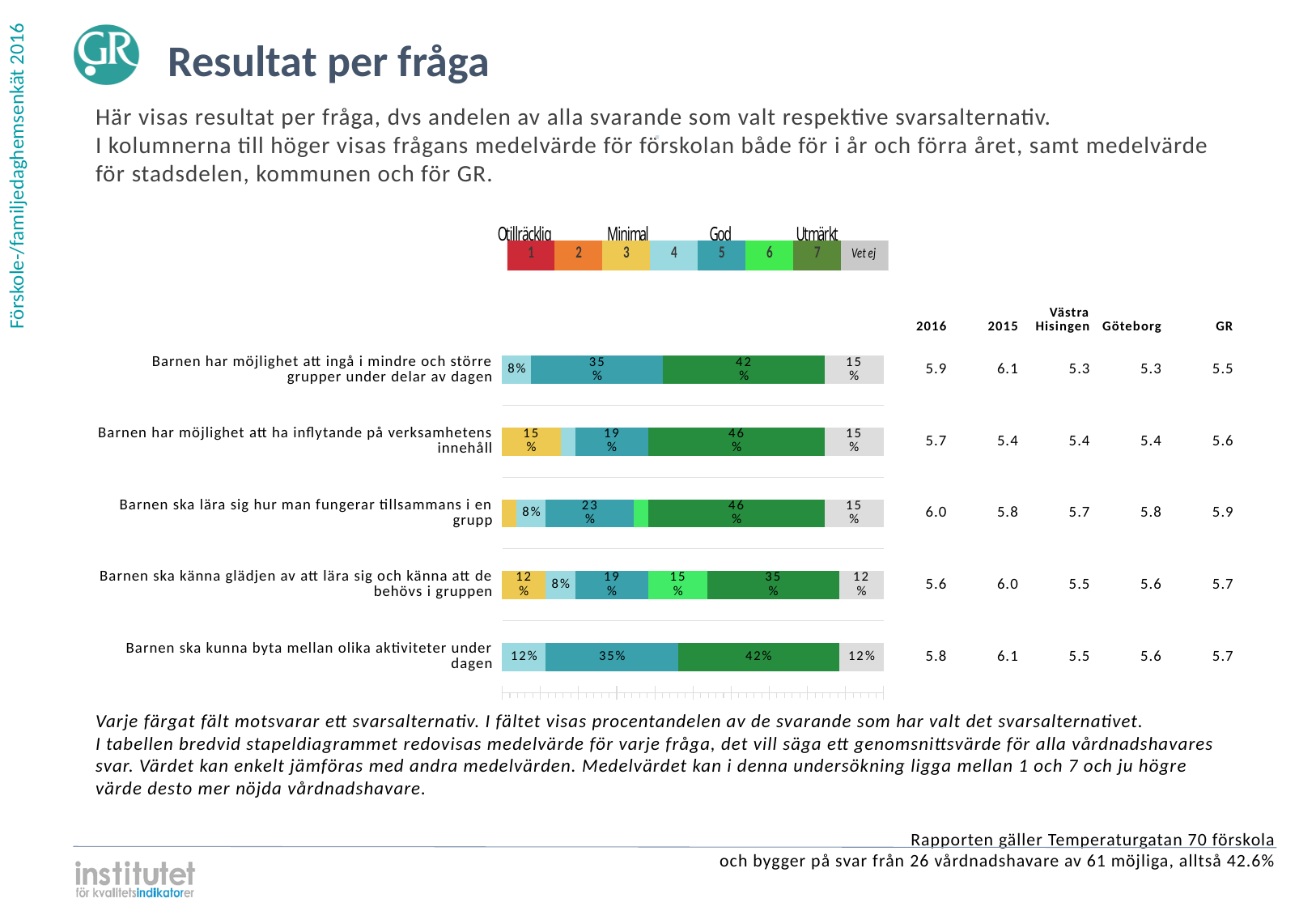
Which is larger: the teal (5) segment for 'Barnen ska lära sig hur man fungerar tillsammans i en grupp' or for 'Barnen ska kunna byta mellan olika aktiviteter under dagen'? Barnen ska kunna byta mellan olika aktiviteter under dagen What is the difference between the dark green (7) share for 'Barnen ska lära sig hur man fungerar tillsammans i en grupp' (46%) and for 'Barnen ska känna glädjen av att lära sig och känna att de behövs i gruppen' (35%)? 11 percentage points What is the share of the yellow (3) segment for 'Barnen ska känna glädjen av att lära sig och känna att de behövs i gruppen'? 12% What percentage of respondents chose option 5 (teal) for 'Barnen ska kunna byta mellan olika aktiviteter under dagen'? 35% Which response category in the legend is shown in dark green? Utmärkt (7) What is the share of the dark green (7) segment for 'Barnen ska känna glädjen av att lära sig och känna att de behövs i gruppen'? 35% How many questions (categories) are plotted in the bar chart? 5 What percentage of respondents answered 'Vet ej' for 'Barnen har möjlighet att ha inflytande på verksamhetens innehåll'? 15% Which question has the smallest dark green (7) segment? Barnen ska känna glädjen av att lära sig och känna att de behövs i gruppen What percentage of respondents chose 'Utmärkt' (7) for 'Barnen har möjlighet att ingå i mindre och större grupper under delar av dagen'? 42% What percentage of respondents chose option 6 (bright green) for 'Barnen ska känna glädjen av att lära sig och känna att de behövs i gruppen'? 15% What kind of chart is shown on the slide? Stacked bar chart